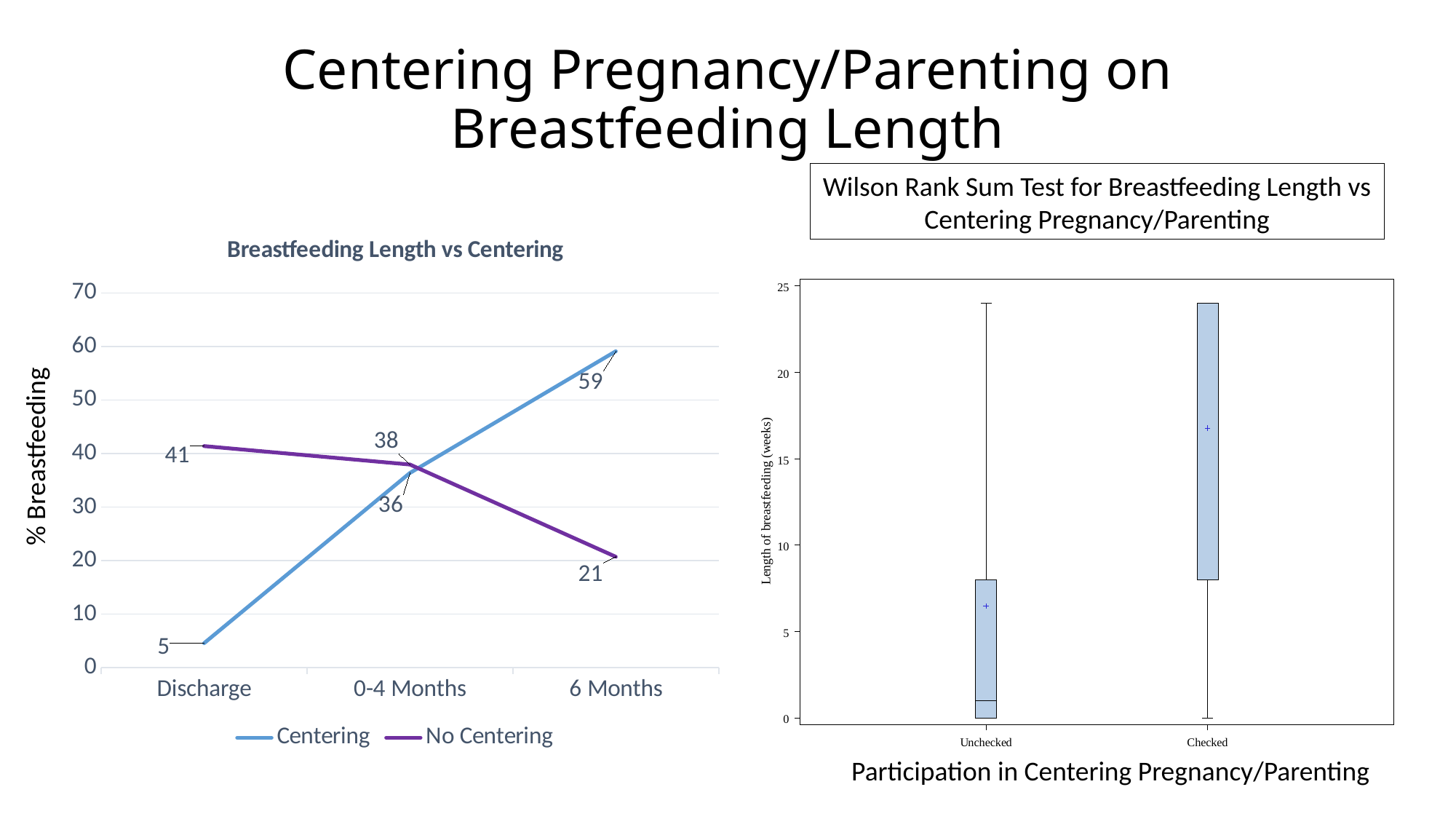
In the 'Breastfeeding Length vs Centering' chart, does the Centering series rise or fall from Discharge to 6 Months? rise In the 'Breastfeeding Length vs Centering' chart, which series has the larger value at Discharge, Centering or No Centering? No Centering How many series does the legend of the 'Breastfeeding Length vs Centering' chart list? 2 In the 'Breastfeeding Length vs Centering' chart, at which time point is the Centering series highest? 6 Months What kind of chart is the 'Breastfeeding Length vs Centering' chart on the left of the slide? line chart In the 'Breastfeeding Length vs Centering' chart, what is the value for Centering at Discharge? 5 In the 'Breastfeeding Length vs Centering' chart, what is the value for Centering at 6 Months? 59 In the 'Breastfeeding Length vs Centering' chart, at which time point is the No Centering series lowest? 6 Months In the 'Breastfeeding Length vs Centering' chart, what is the value for No Centering at 6 Months? 21 In the 'Breastfeeding Length vs Centering' chart, what is the difference between Centering and No Centering at 6 Months? 38 In the box plot on the right of the slide, how many categories are shown on the x axis? 2 In the 'Breastfeeding Length vs Centering' chart, what is the value for No Centering at 0-4 Months? 38